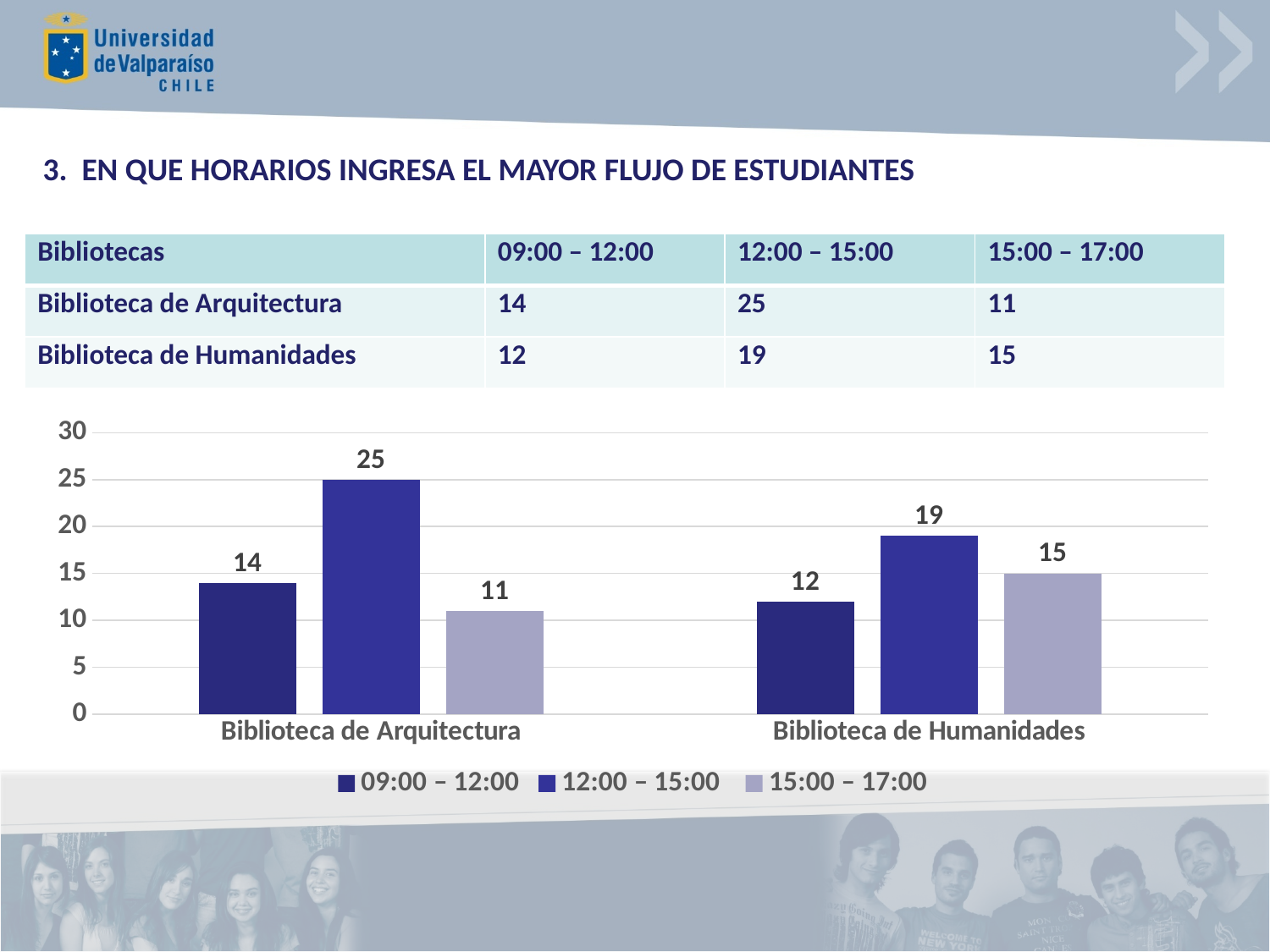
What is the value for Biblioteca de Humanidades in the 09:00 – 12:00 series? 12 Which time slot has the lowest value for Biblioteca de Humanidades? 09:00 – 12:00 How many series does the chart legend list? 3 What is the total of the three values for Biblioteca de Arquitectura? 50 Is the 12:00 – 15:00 value for Biblioteca de Arquitectura greater or less than 20? greater What is the value for Biblioteca de Arquitectura in the 12:00 – 15:00 series? 25 What kind of chart is shown on the slide? bar chart Which is larger: the 15:00 – 17:00 value for Biblioteca de Arquitectura or for Biblioteca de Humanidades? Biblioteca de Humanidades What is the difference between the 12:00 – 15:00 values for Biblioteca de Arquitectura and Biblioteca de Humanidades? 6 What is the value for Biblioteca de Humanidades in the 15:00 – 17:00 series? 15 How many categories are shown on the x axis of the chart? 2 Which time slot has the highest value for Biblioteca de Arquitectura? 12:00 – 15:00